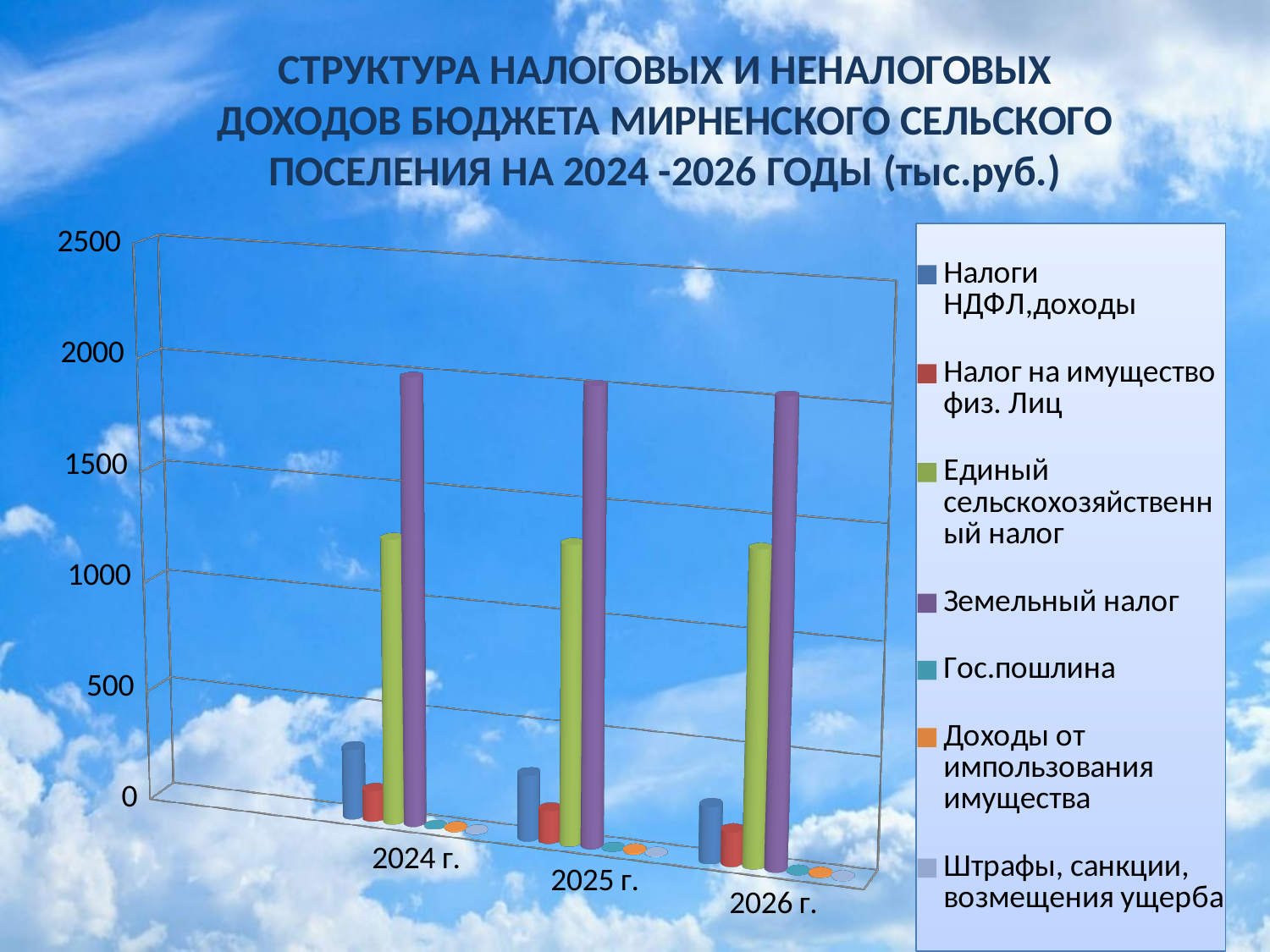
How many years (categories) are shown on the x axis of the chart? 3 What colour represents Земельный налог in the chart legend? purple How many series does the chart legend list? 7 In 2025 г., which is larger: Земельный налог or Единый сельскохозяйственный налог? Земельный налог What kind of chart is shown on the slide? bar chart Is the value for Земельный налог in 2024 г. greater or less than 1500? greater Does the value for Налоги НДФЛ,доходы rise or fall from 2024 г. to 2026 г.? fall Which series has the highest value in 2024 г.? Земельный налог Which series has the highest value in 2026 г.? Земельный налог Is the value for Единый сельскохозяйственный налог in 2024 г. greater or less than 1000? greater Is the value for Налоги НДФЛ,доходы in 2024 г. greater or less than 500? less